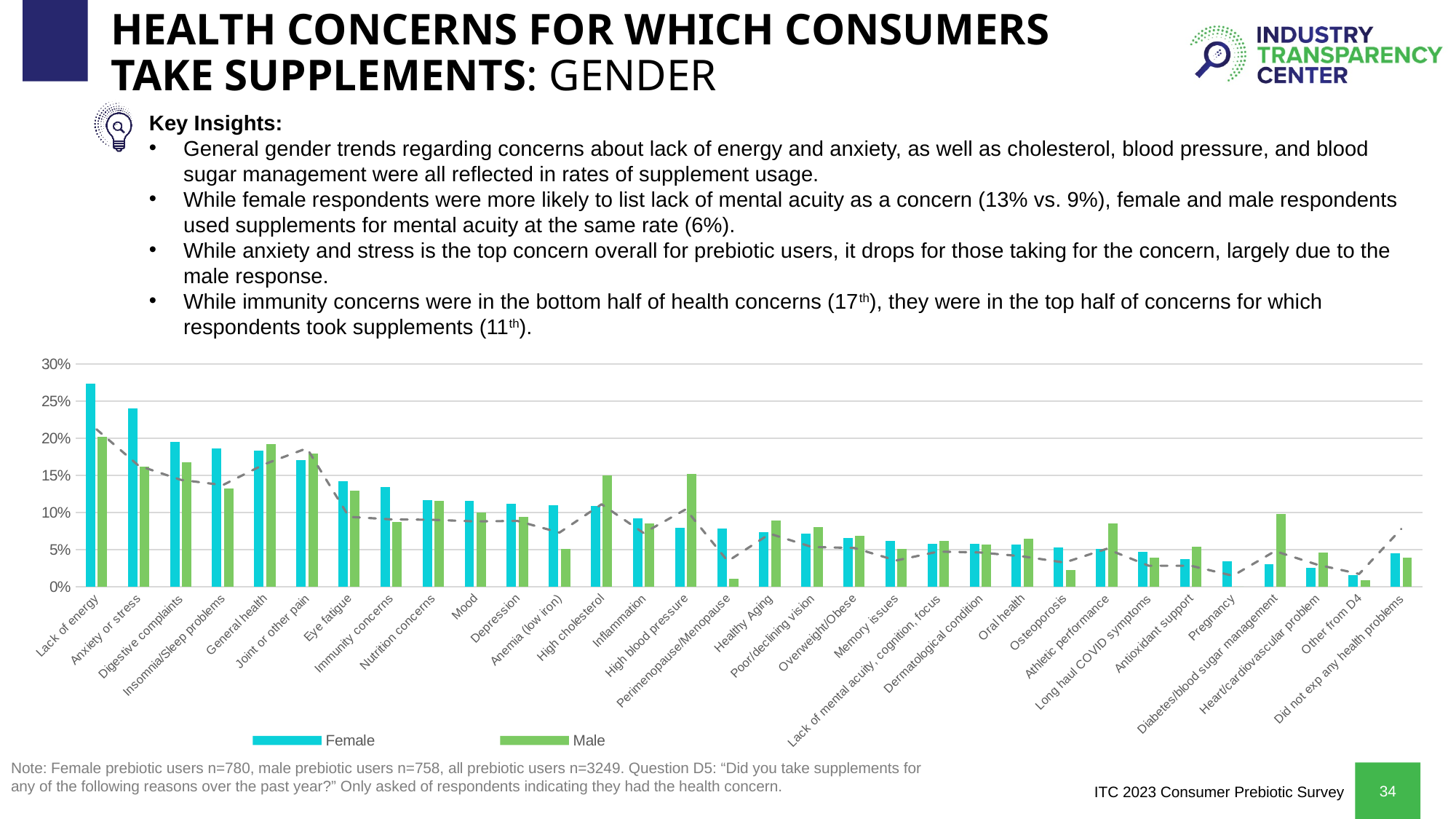
How many series does the chart legend list? 2 How many health concern categories are shown on the x axis of the chart? 32 For Anemia (low iron), which is larger, the Female value or the Male value? Female Is the Male value for Perimenopause/Menopause greater or less than 5%? less Is the Male value for Anxiety or stress greater or less than 20%? less Which category has the highest Male value in the chart? Lack of energy Is the Female value for Lack of energy greater or less than 25%? greater Which category has the highest Female value in the chart? Lack of energy Which two series are listed in the chart legend? Female and Male For High blood pressure, which is larger, the Female value or the Male value? Male What kind of chart is shown on the slide? combination bar and line chart Do the Female values generally rise or fall moving from left to right along the x axis? fall